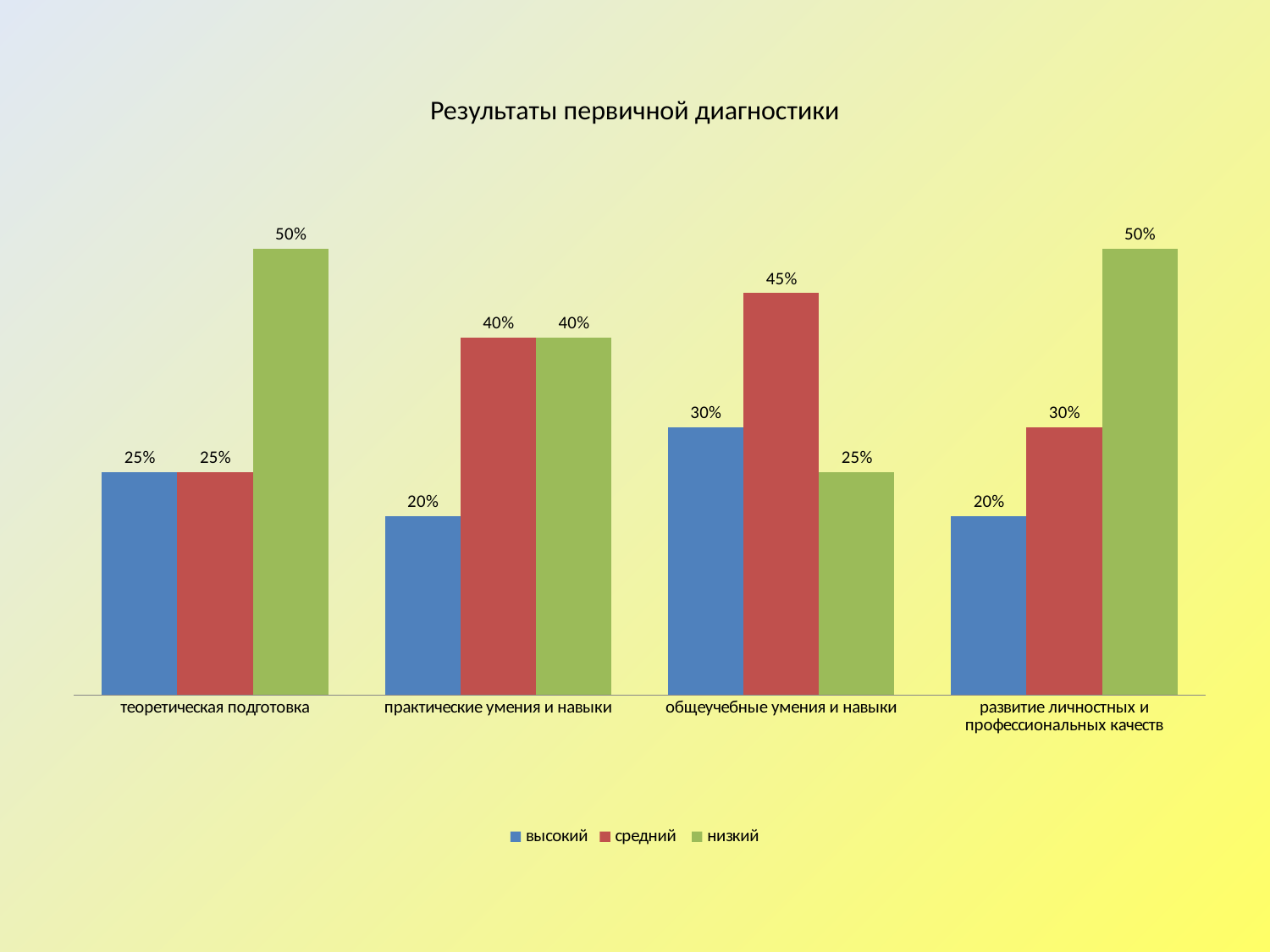
What is the title of the chart? Результаты первичной диагностики What is the value for 'средний' in the 'общеучебные умения и навыки' category? 45% What is the value for 'низкий' in the 'развитие личностных и профессиональных качеств' category? 50% How many categories are shown on the x axis? 4 What kind of chart is shown on the slide? bar chart What is the value for 'высокий' in the 'теоретическая подготовка' category? 25% What is the value for 'высокий' in the 'практические умения и навыки' category? 20% Which series has the lowest value in the 'развитие личностных и профессиональных качеств' category? высокий What is the difference between the 'низкий' and 'высокий' values in the 'теоретическая подготовка' category? 25% Which series has the highest value in the 'общеучебные умения и навыки' category? средний How many series does the legend list? 3 Which is larger in the 'практические умения и навыки' category: 'средний' or 'высокий'? средний